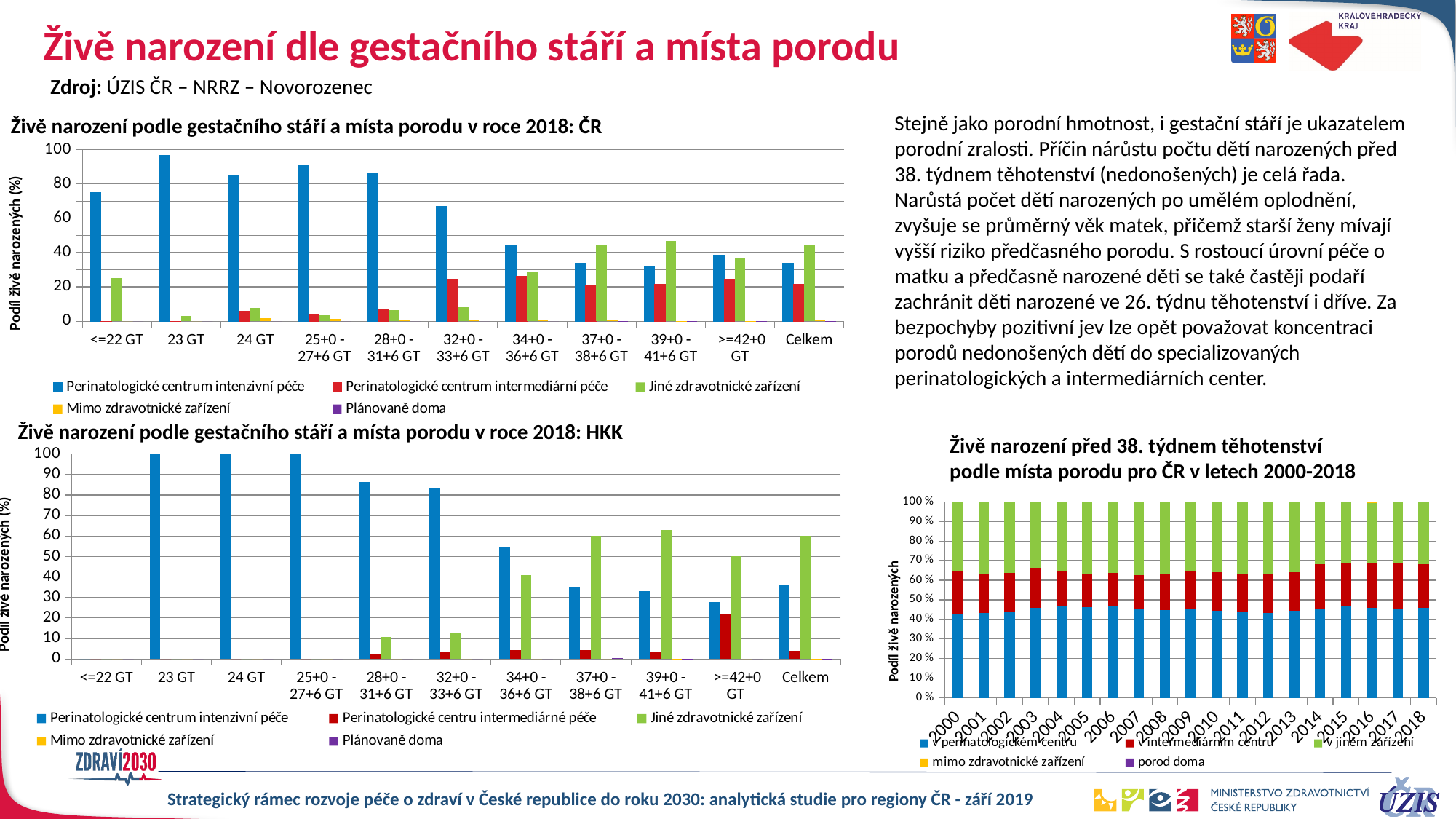
In the chart 'Živě narození podle gestačního stáří a místa porodu v roce 2018: ČR', for the category 39+0 - 41+6 GT, which is larger: Perinatologické centrum intenzivní péče or Jiné zdravotnické zařízení? Jiné zdravotnické zařízení In the chart 'Živě narození podle gestačního stáří a místa porodu v roce 2018: HKK', what is the value for Perinatologické centrum intenzivní péče at 24 GT? 100 In the chart 'Živě narození podle gestačního stáří a místa porodu v roce 2018: ČR', is the value for Perinatologické centrum intenzivní péče at 23 GT greater or less than 80? greater What kind of chart is 'Živě narození před 38. týdnem těhotenství podle místa porodu pro ČR v letech 2000-2018'? stacked bar chart In the chart 'Živě narození před 38. týdnem těhotenství podle místa porodu pro ČR v letech 2000-2018', how many years are shown on the x axis? 19 In the chart 'Živě narození před 38. týdnem těhotenství podle místa porodu pro ČR v letech 2000-2018', is the value for 'v perinatologickém centru' in 2018 greater or less than 50 %? less In the chart 'Živě narození podle gestačního stáří a místa porodu v roce 2018: ČR', how many series does the legend list? 5 In the chart 'Živě narození podle gestačního stáří a místa porodu v roce 2018: ČR', which category has the highest value for Perinatologické centrum intenzivní péče? 23 GT In the chart 'Živě narození podle gestačního stáří a místa porodu v roce 2018: ČR', how many gestational-age categories are shown on the x axis? 11 In the chart 'Živě narození podle gestačního stáří a místa porodu v roce 2018: HKK', what is the value for Perinatologické centrum intenzivní péče at 23 GT? 100 In the chart 'Živě narození podle gestačního stáří a místa porodu v roce 2018: HKK', is the value for Jiné zdravotnické zařízení at 39+0 - 41+6 GT greater or less than 60? greater In the chart 'Živě narození podle gestačního stáří a místa porodu v roce 2018: HKK', for the category Celkem, which is larger: Perinatologické centrum intenzivní péče or Jiné zdravotnické zařízení? Jiné zdravotnické zařízení